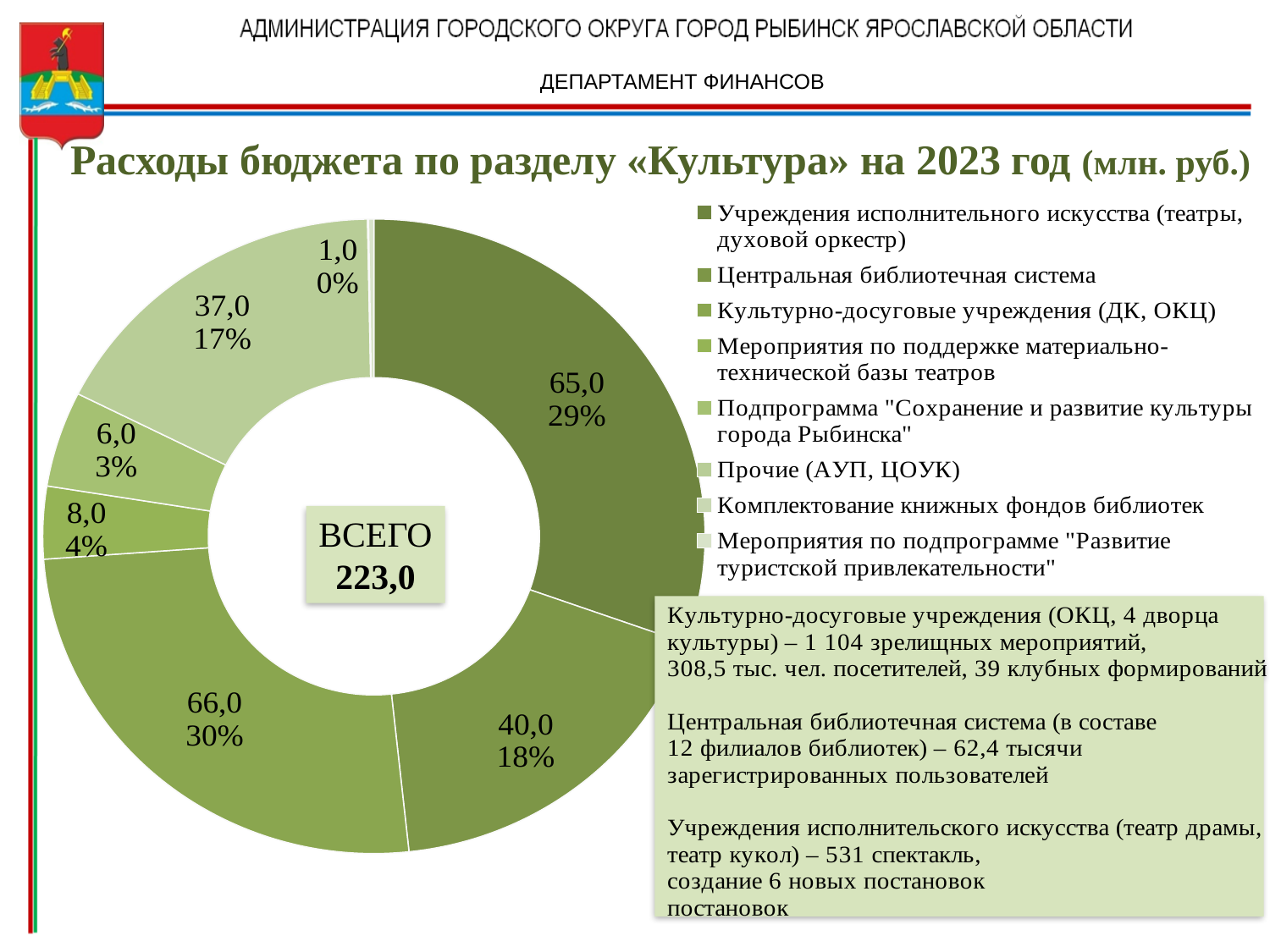
What is the title of the chart on the slide? Расходы бюджета по разделу «Культура» на 2023 год (млн. руб.) What share of the total does 'Учреждения исполнительного искусства (театры, духовой оркестр)' represent? 29% Which is larger: the slice for 'Учреждения исполнительного искусства' (65,0) or the slice for 'Центральная библиотечная система' (40,0)? Учреждения исполнительного искусства What is the value for 'Учреждения исполнительного искусства (театры, духовой оркестр)'? 65,0 What share of the total does the largest slice (66,0) represent? 30% How many entries does the chart legend list? 8 What is the value for 'Культурно-досуговые учреждения (ДК, ОКЦ)'? 66,0 What is the value for 'Центральная библиотечная система'? 40,0 What is the difference between the slice labelled 66,0 and the slice labelled 65,0? 1,0 What is the value of the largest slice of the chart? 66,0 What is the total value shown in the centre of the chart? 223,0 What kind of chart is shown on the slide? Pie (doughnut) chart